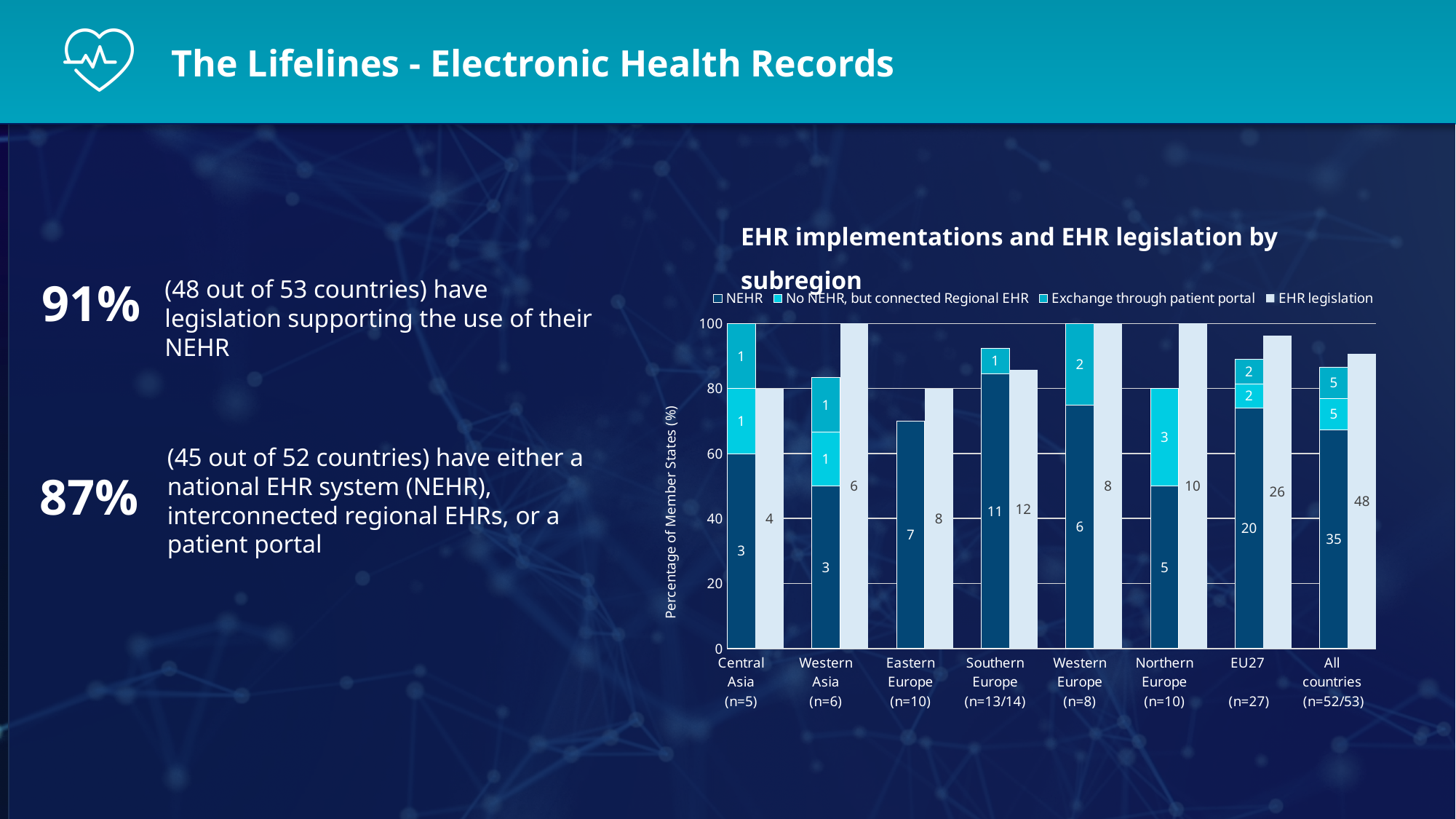
What is the data label for NEHR in the EU27 bar? 20 What is the data label for 'Exchange through patient portal' for Western Europe? 2 What kind of chart is shown on the slide? Stacked bar chart Is the EHR legislation bar for EU27 greater or less than 80 on the percentage axis? greater How many subregion categories are shown along the x axis of the chart? 8 What is the difference between the EHR legislation label and the NEHR label for All countries? 13 What is the data label for EHR legislation for Northern Europe? 10 Which category has the highest EHR legislation data label? All countries (n=52/53) How many series does the chart legend list? 4 Which category has the lowest EHR legislation data label? Central Asia (n=5) Which has the larger NEHR data label, Western Europe or Northern Europe? Western Europe What is the total of the data labels in the stacked bar for Central Asia? 5